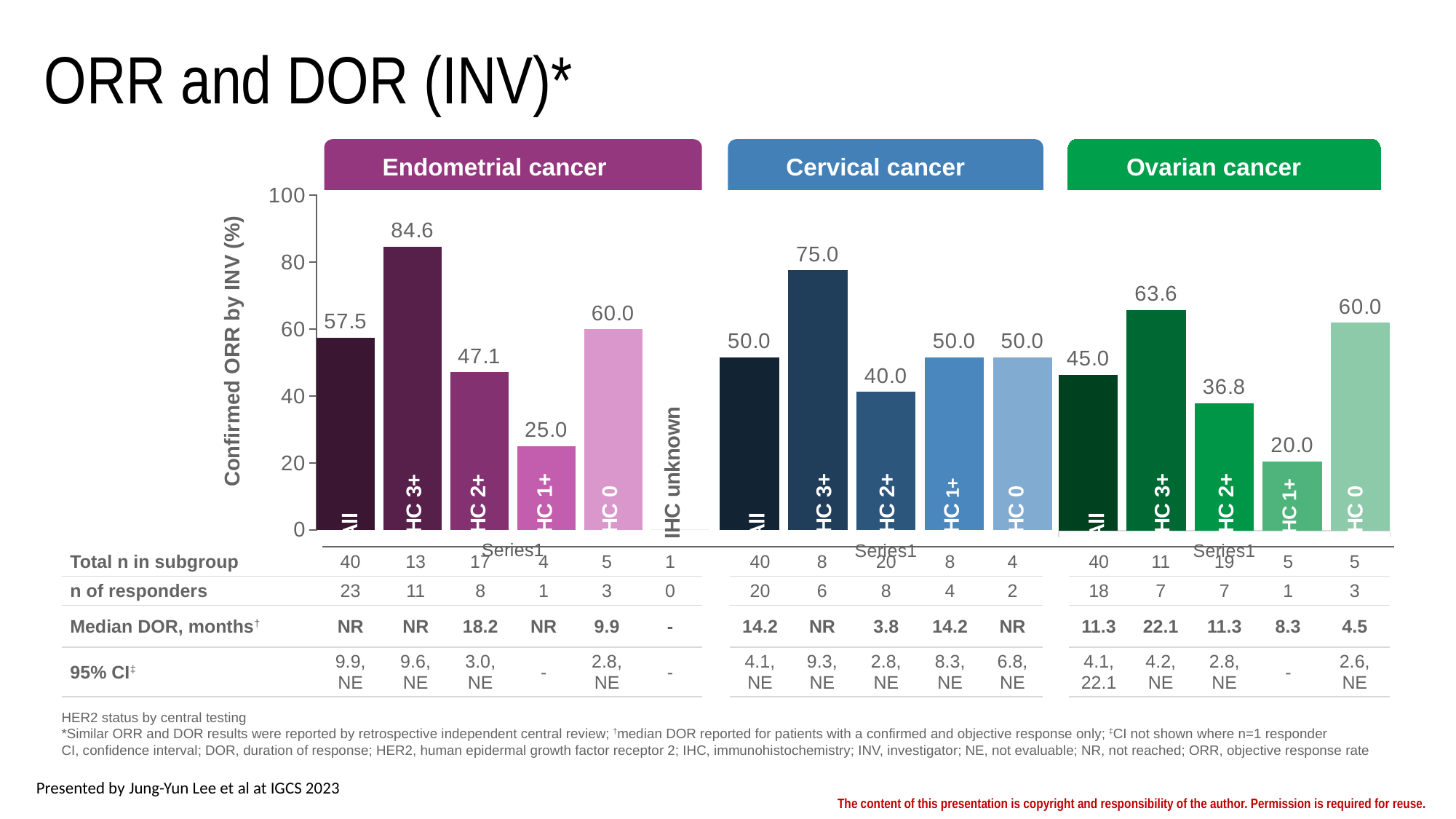
In the Ovarian cancer chart, what is the confirmed ORR for the All subgroup? 45.0 How many subgroup bars are plotted in the Cervical cancer chart? 5 What type of chart is used to show confirmed ORR by INV on this slide? bar chart Which has a higher confirmed ORR: the IHC 0 subgroup in the Ovarian cancer chart or the IHC 0 subgroup in the Cervical cancer chart? Ovarian cancer IHC 0 In the Endometrial cancer chart, what is the confirmed ORR for the IHC 3+ subgroup? 84.6 In the Cervical cancer chart, what is the confirmed ORR for the IHC 2+ subgroup? 40.0 In the Ovarian cancer chart, which subgroup has the highest confirmed ORR? IHC 3+ In the Endometrial cancer chart, what is the difference in confirmed ORR between the IHC 0 and All subgroups? 2.5 In the Cervical cancer chart, what is the difference in confirmed ORR between the IHC 3+ and IHC 2+ subgroups? 35.0 What is the label of the y-axis on the chart? Confirmed ORR by INV (%) In the Endometrial cancer chart, which subgroup with a plotted bar has the lowest confirmed ORR? IHC 1+ In the Ovarian cancer chart, is the confirmed ORR for the IHC 2+ subgroup greater or less than 40? less